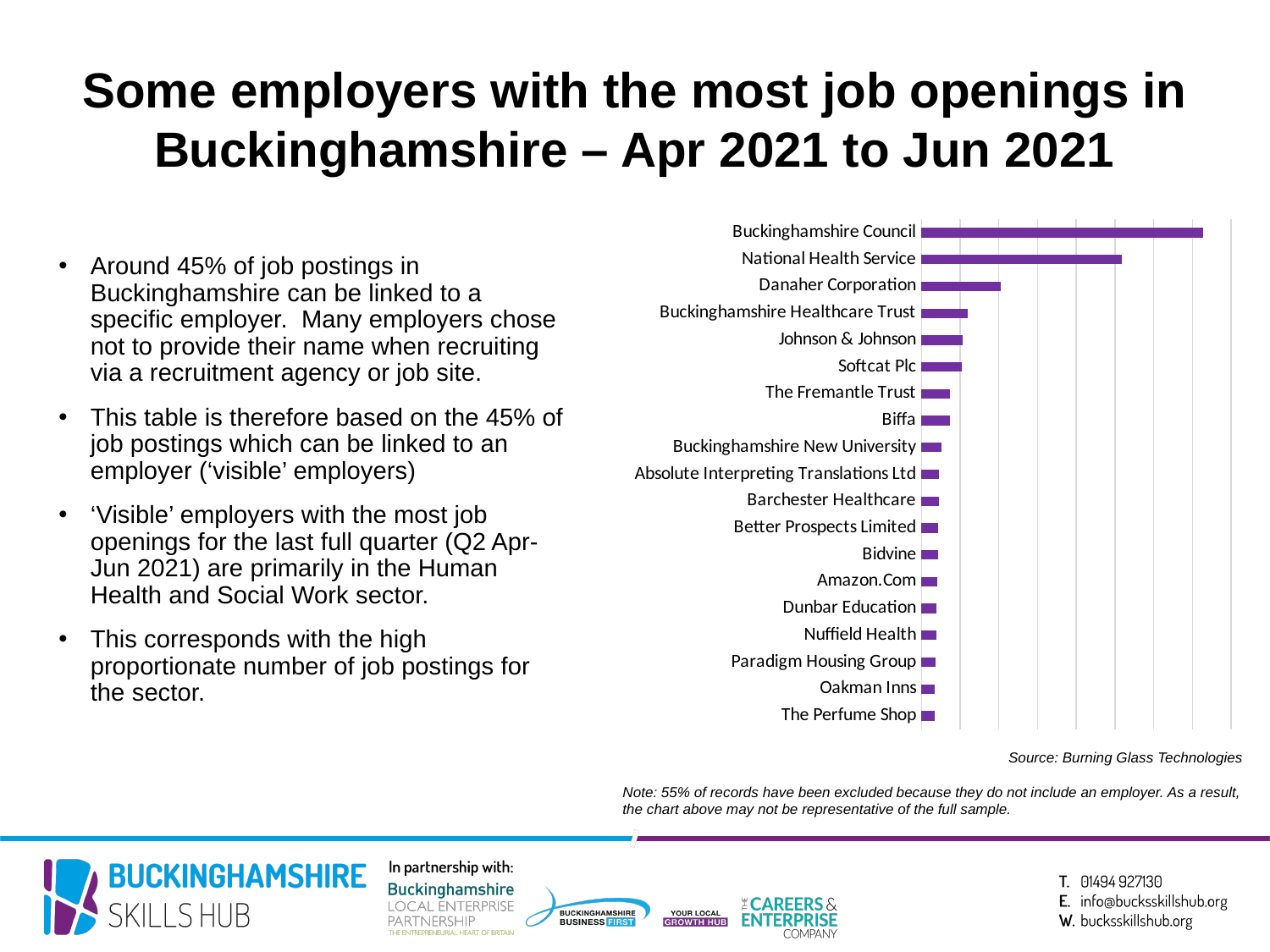
What type of chart is shown on the slide? Bar chart What colour are the bars in the chart? Purple Which employer has the highest number of job openings in the chart? Buckinghamshire Council How many employers are listed in the chart? 19 Which has the longer bar, National Health Service or Danaher Corporation? National Health Service Which employer has the third-longest bar in the chart? Danaher Corporation Which employer is listed at the bottom of the chart? The Perfume Shop Do the bar lengths increase or decrease going from the top of the chart to the bottom? Decrease Which has the longer bar, Buckinghamshire Council or National Health Service? Buckinghamshire Council Which employer has the second-longest bar in the chart? National Health Service Which has the longer bar, Buckinghamshire Healthcare Trust or Biffa? Buckinghamshire Healthcare Trust